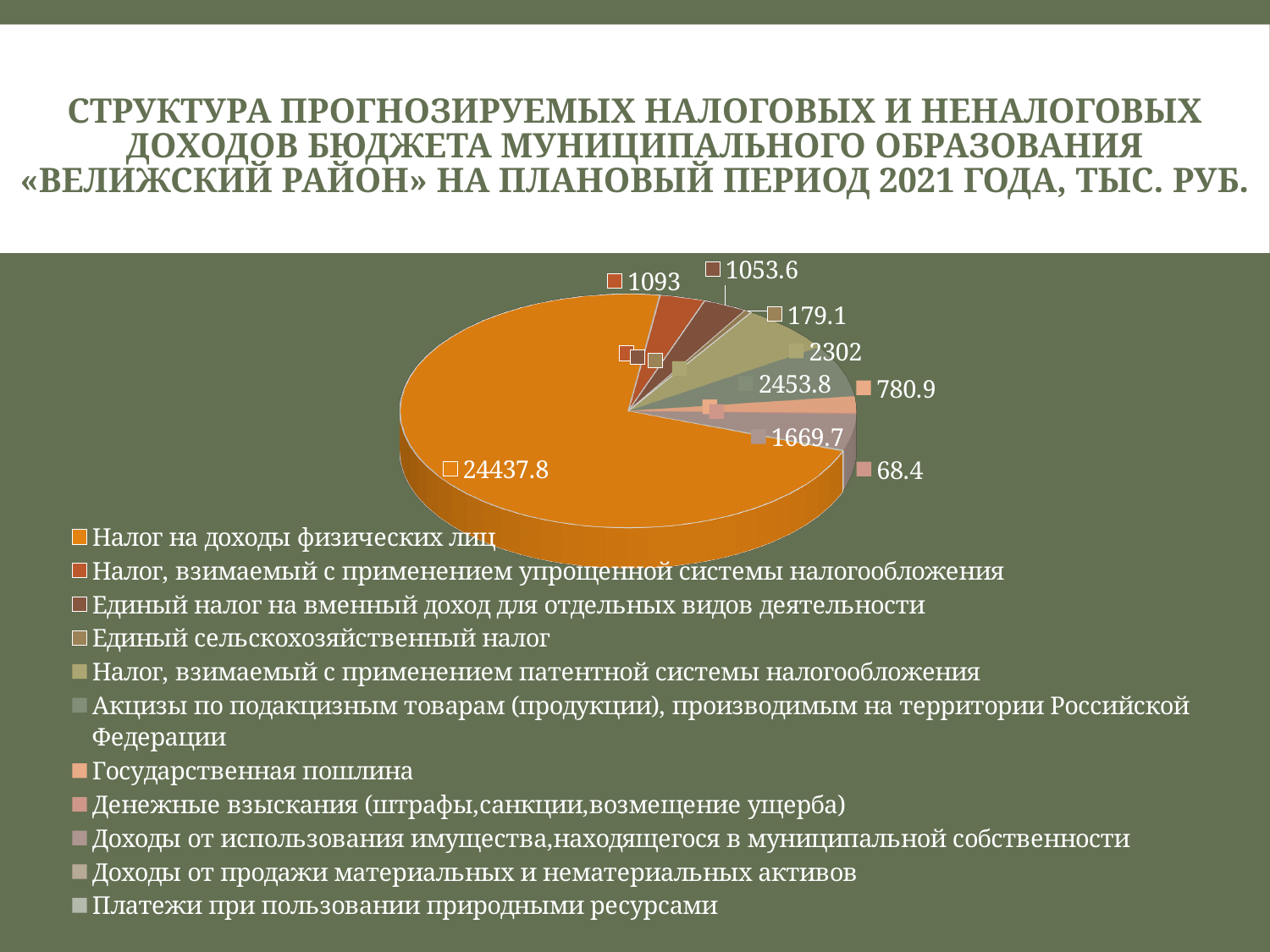
How many categories does the legend of the pie chart list? 11 What is the value for «Единый налог на вменный доход для отдельных видов деятельности»? 1053.6 What is the value for «Акцизы по подакцизным товарам (продукции), производимым на территории Российской Федерации»? 2453.8 What is the value for «Налог на доходы физических лиц»? 24437.8 What is the value for «Налог, взимаемый с применением упрощенной системы налогообложения»? 1093 Which category has the largest slice of the pie? Налог на доходы физических лиц What is the value for «Единый сельскохозяйственный налог»? 179.1 What is the value for «Налог, взимаемый с применением патентной системы налогообложения»? 2302 What is the value for «Государственная пошлина»? 780.9 What kind of chart is shown on the slide? Pie chart Which is larger: the value for «Акцизы по подакцизным товарам» or the value for «Налог, взимаемый с применением патентной системы налогообложения»? Акцизы по подакцизным товарам What is the difference between the value for «Акцизы по подакцизным товарам» (2453.8) and the value for «Налог, взимаемый с применением патентной системы налогообложения» (2302)? 151.8